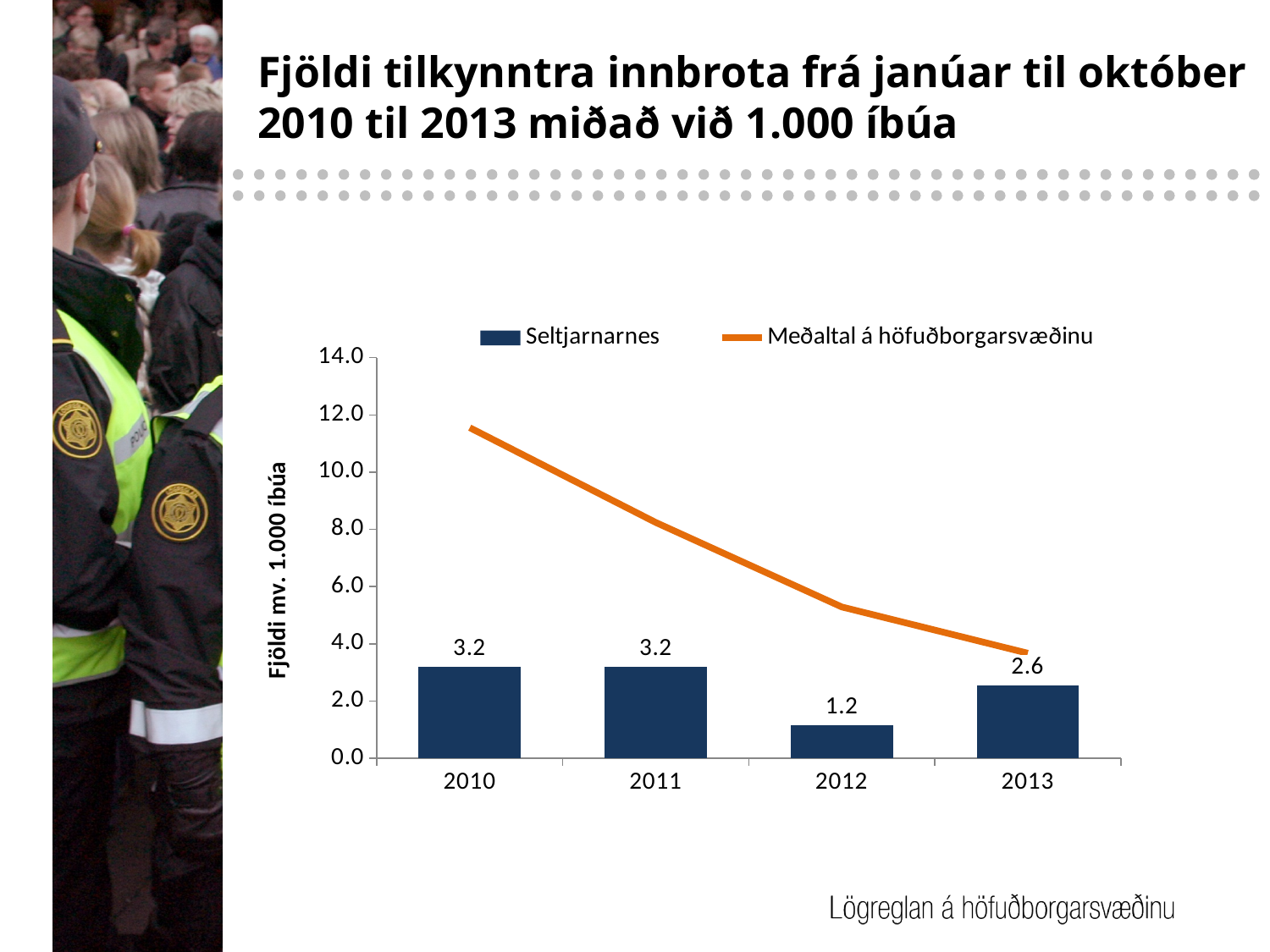
Which is larger for Seltjarnarnes, the value for 2012 or the value for 2013? 2013 What is the difference between the Seltjarnarnes values for 2011 and 2012? 2.0 Is the value for Meðaltal á höfuðborgarsvæðinu in 2013 greater or less than 4.0? less What is the value for Seltjarnarnes in 2012? 1.2 Does the Meðaltal á höfuðborgarsvæðinu line rise or fall from 2010 to 2013? fall What is the value for Seltjarnarnes in 2013? 2.6 How many years are shown on the x axis? 4 What is the label on the y axis? Fjöldi mv. 1.000 íbúa Is the value for Meðaltal á höfuðborgarsvæðinu in 2010 greater or less than 10.0? greater What is the value for Seltjarnarnes in 2010? 3.2 How many series does the legend list? 2 In which year is the Seltjarnarnes value lowest? 2012